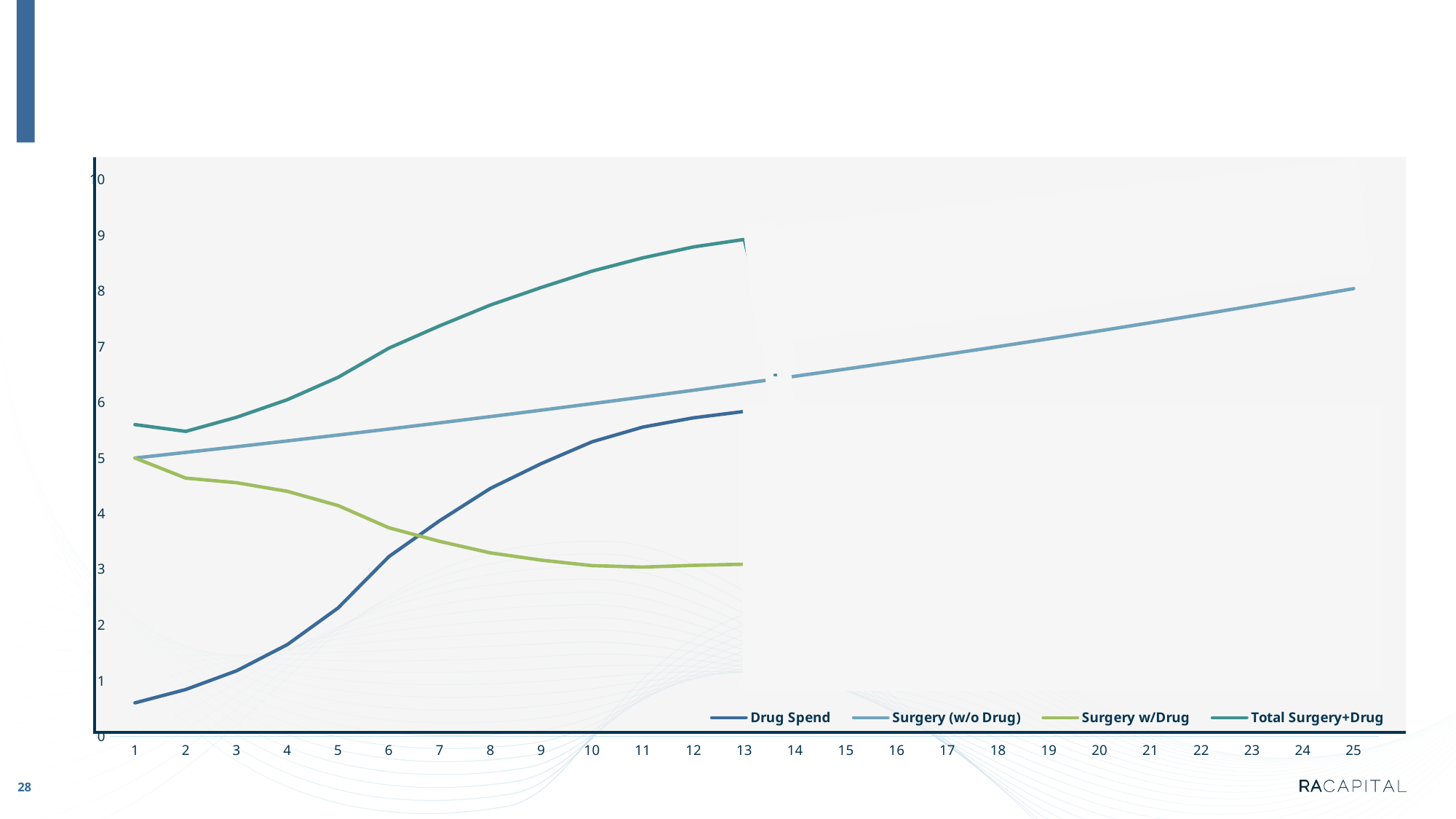
How many series does the legend list? 4 Is the value for Surgery (w/o Drug) at x = 25 greater or less than 7? greater Which series has the lowest value at x = 13? Surgery w/Drug Is the value for Drug Spend at x = 1 greater or less than 1? less Does the Surgery w/Drug line rise or fall from x = 1 to x = 13? fall Is the value for Surgery w/Drug at x = 13 greater or less than 4? less Which series is the only one plotted all the way to x = 25? Surgery (w/o Drug) What kind of chart is shown on the slide? line chart Which series has the highest value at x = 13? Total Surgery+Drug At x = 13, which is larger: Drug Spend or Surgery w/Drug? Drug Spend How many points are labelled along the x axis? 25